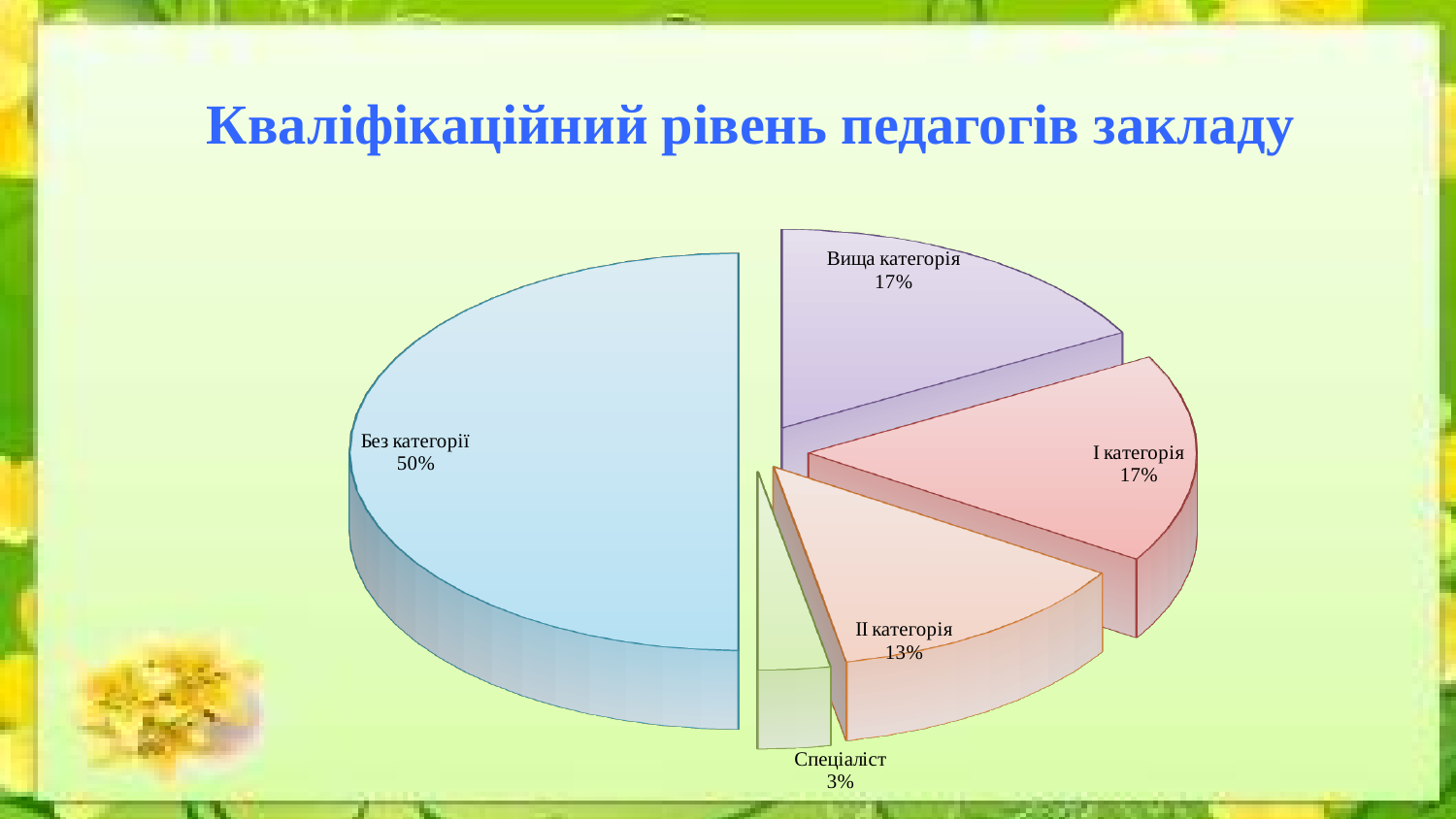
What kind of chart is shown on the slide? Pie chart Which category has the smallest slice of the pie? Спеціаліст How many slices does the pie chart have? 5 What is the difference between the shares of "Без категорії" and "І категорія"? 33% What percentage is shown for "Спеціаліст"? 3% What percentage is shown for "ІІ категорія"? 13% What percentage is shown for "Вища категорія"? 17% What is the difference between the shares of "ІІ категорія" and "Спеціаліст"? 10% Which is larger, the share of "ІІ категорія" or the share of "Спеціаліст"? ІІ категорія Which category has the largest slice of the pie? Без категорії What share of the pie does "Без категорії" have? 50% What is the title of the chart? Кваліфікаційний рівень педагогів закладу